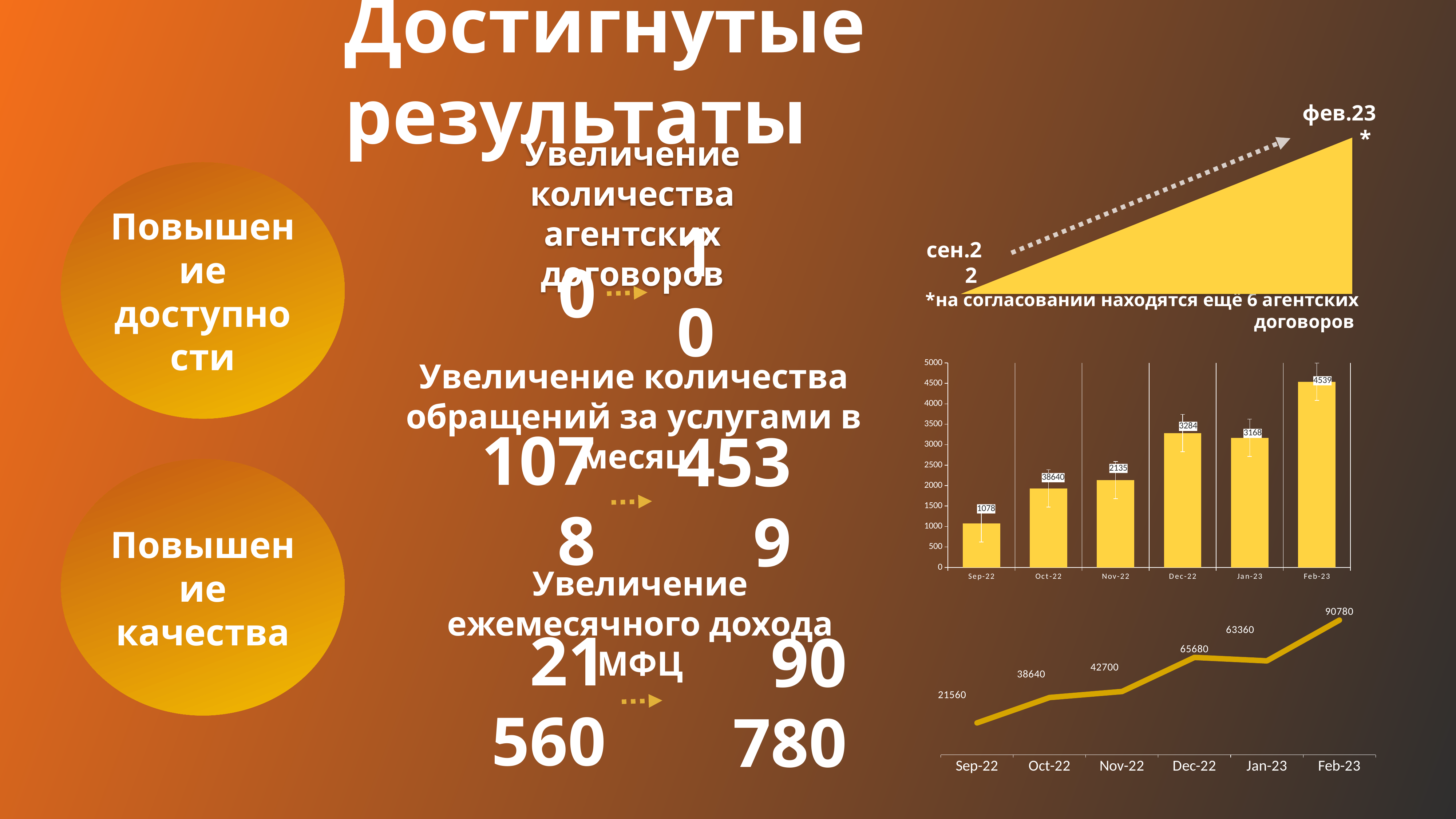
In the bottom line chart, what is the difference between the Feb-23 and Sep-22 values? 69220 In the bottom line chart, do the values generally rise or fall from Sep-22 to Feb-23? rise In the middle bar chart, which month has the lowest value? Sep-22 In the middle bar chart, is the value for Oct-22 greater or less than 1500? greater In the middle bar chart, which is larger, the value for Dec-22 or Jan-23? Dec-22 What kind of chart is the bottom chart on the slide? line chart In the bottom line chart, what is the value for Dec-22? 65680 In the middle bar chart, what is the value for Feb-23? 4539 In the middle bar chart, which month has the highest value? Feb-23 In the middle bar chart, what is the difference between the Feb-23 and Sep-22 values? 3461 In the middle bar chart, what is the value for Sep-22? 1078 How many months are shown on the x axis of the middle bar chart? 6